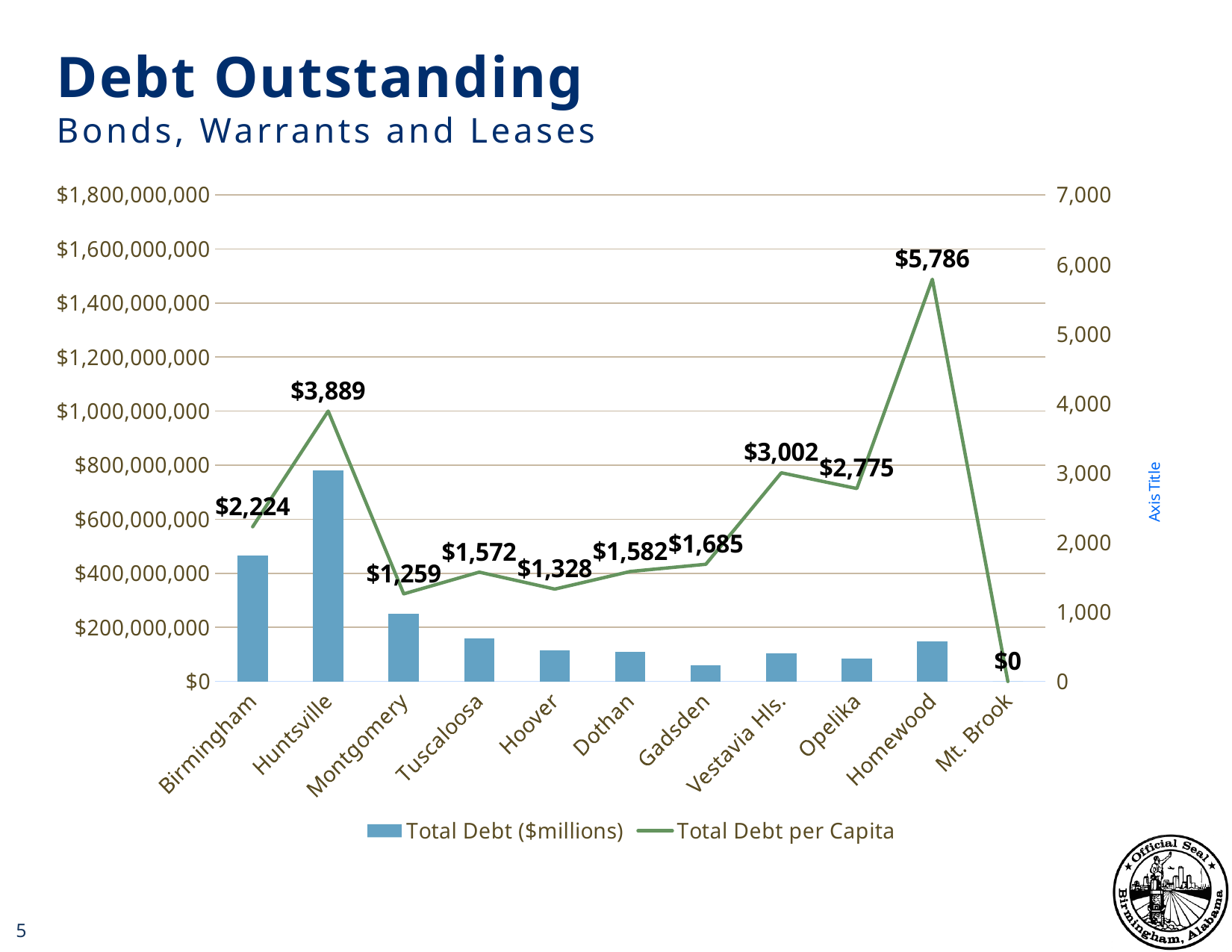
How much higher is the Total Debt per Capita for Huntsville than for Birmingham? $1,665 Is the Total Debt bar for Gadsden greater or less than $200,000,000? less What is the Total Debt per Capita for Montgomery? $1,259 How many cities are shown on the x axis of the chart? 11 What is the Total Debt per Capita for Homewood? $5,786 How many series does the chart legend list? 2 Which city has the lowest Total Debt per Capita? Mt. Brook Is the Total Debt bar for Huntsville greater or less than $600,000,000? greater Which city has the highest Total Debt per Capita? Homewood Which has the larger Total Debt per Capita, Vestavia Hls. or Opelika? Vestavia Hls. How much higher is the Total Debt per Capita for Homewood than for Huntsville? $1,897 Which city has the tallest Total Debt bar? Huntsville